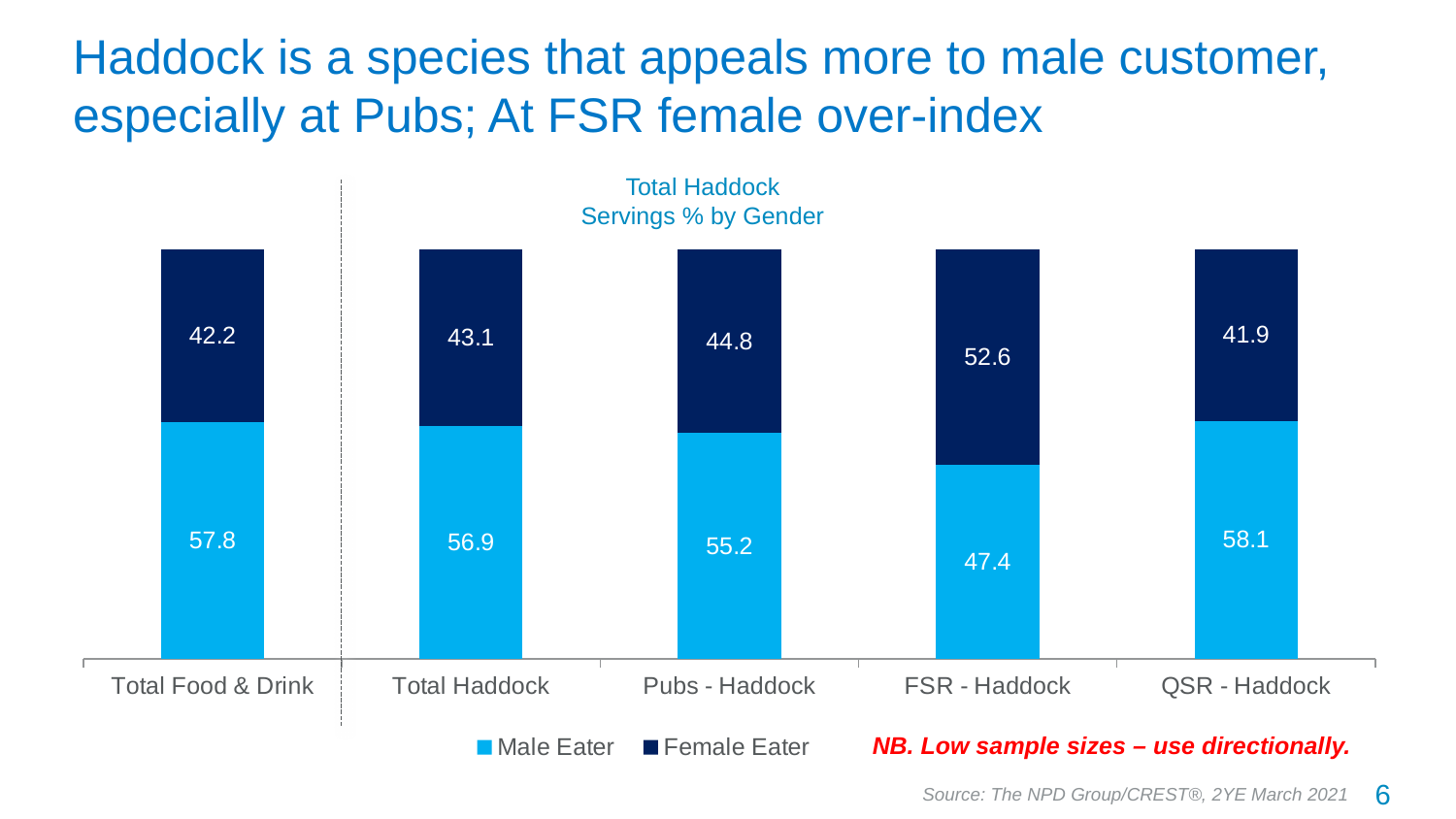
What is the Female Eater value for FSR - Haddock? 52.6 How many series does the legend list? 2 Which category has the highest Female Eater value? FSR - Haddock What is the Male Eater value for Pubs - Haddock? 55.2 What kind of chart is shown on the slide? Stacked bar chart Is the Male Eater value larger for Total Haddock or for FSR - Haddock? Total Haddock What is the total of the stacked bar for Total Haddock? 100 What is the title of the chart? Total Haddock Servings % by Gender Which category has the lowest Male Eater value? FSR - Haddock What is the difference between the Male Eater and Female Eater values for QSR - Haddock? 16.2 How many categories are shown on the x axis? 5 What is the Male Eater value for Total Food & Drink? 57.8